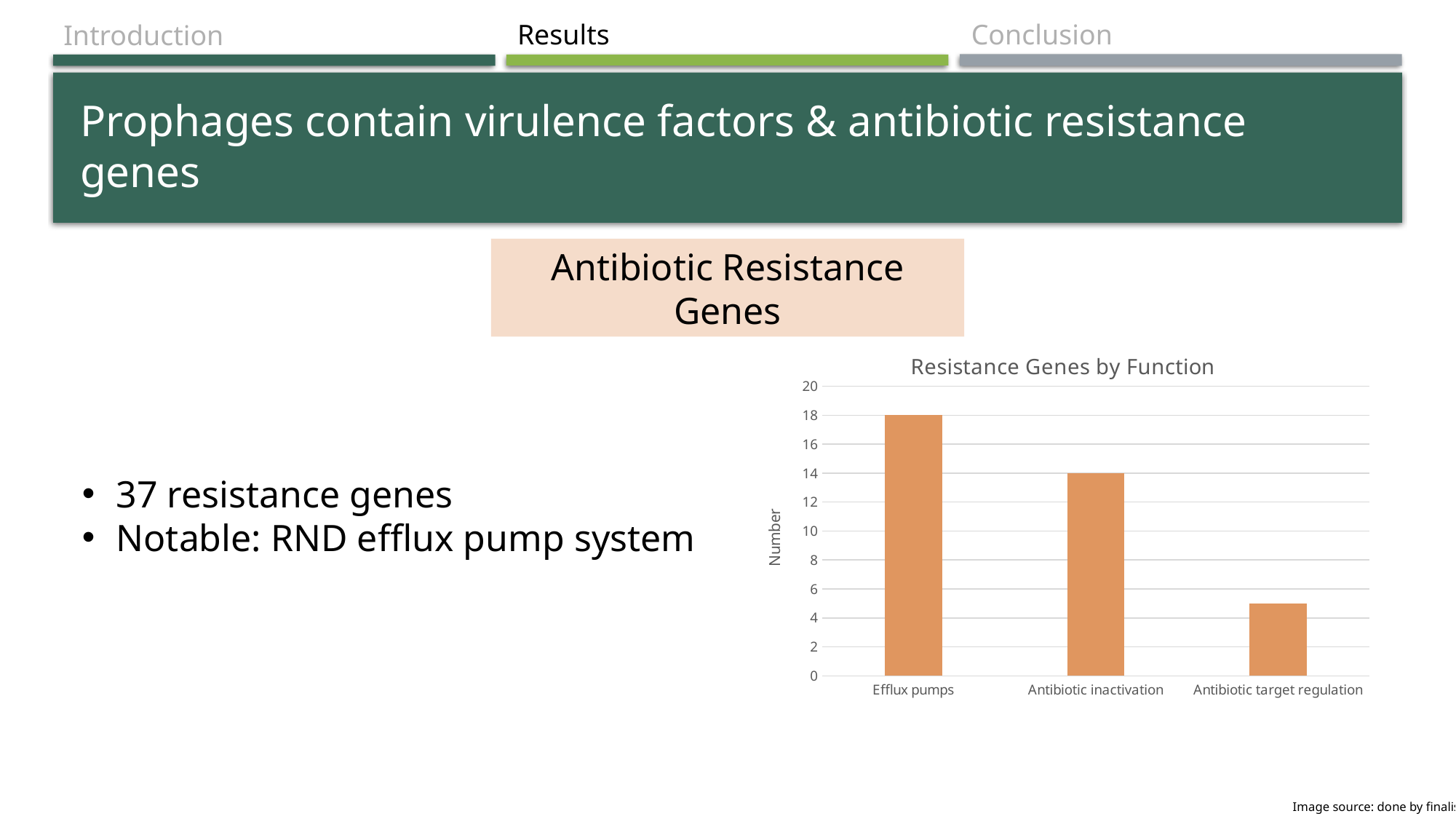
What is the difference between the values for Efflux pumps and Antibiotic inactivation? 4 Which is larger, the value for Antibiotic inactivation or the value for Antibiotic target regulation? Antibiotic inactivation What is the value for Efflux pumps? 18 What is the label of the vertical axis? Number Do the values rise or fall from left to right along the x axis? fall What is the value for Antibiotic inactivation? 14 Is the value for Antibiotic target regulation greater or less than 10? less What is the title of the chart? Resistance Genes by Function How many categories are shown in the chart? 3 Which category has the highest value? Efflux pumps Which category has the lowest value? Antibiotic target regulation What type of chart is shown on the slide? bar chart